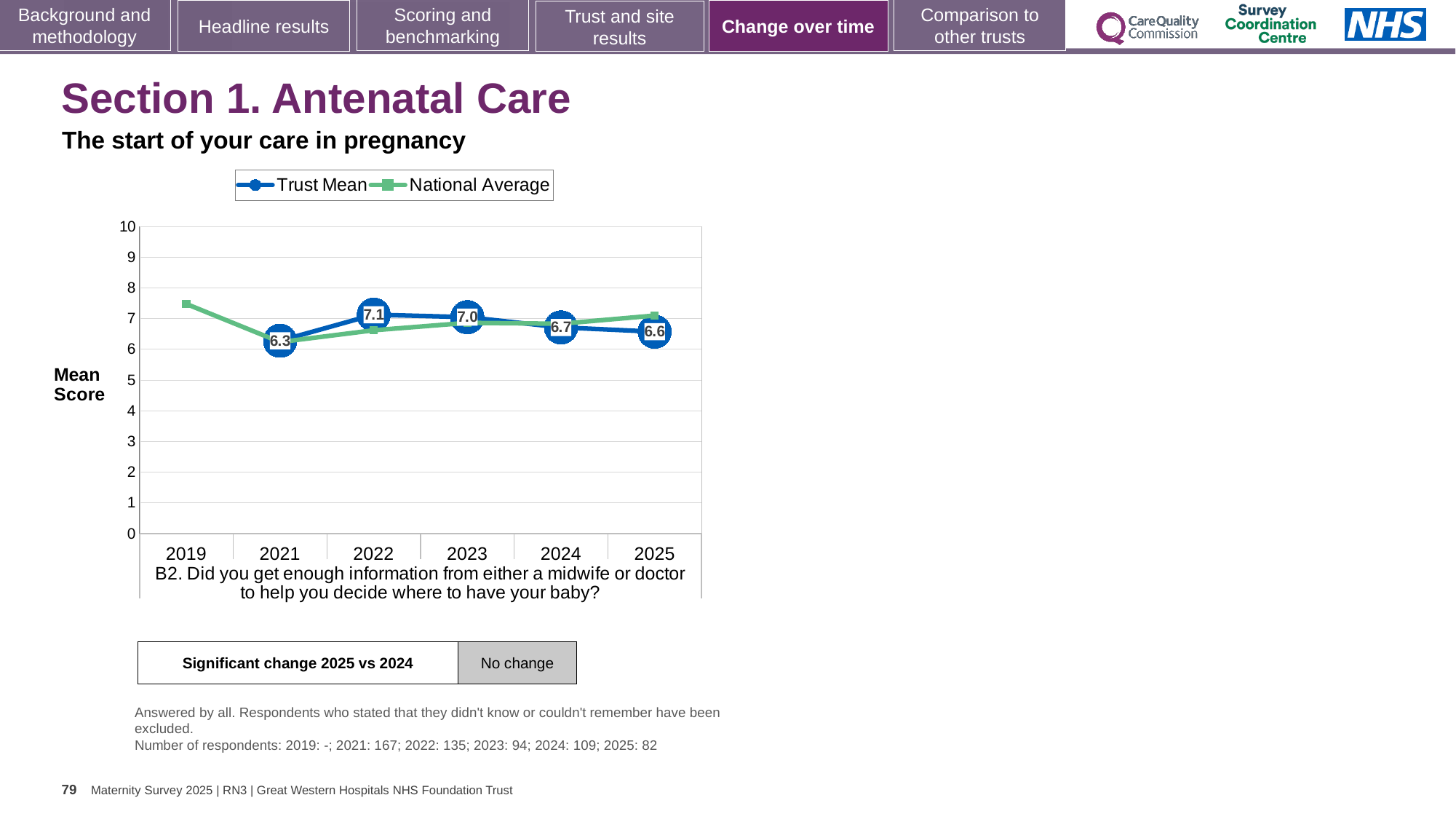
What is the Trust Mean score for 2022? 7.1 In which year is the Trust Mean score lowest? 2021 What is the difference between the Trust Mean scores for 2022 and 2021? 0.8 What is the Trust Mean score for 2025? 6.6 Does the Trust Mean score rise or fall from 2022 to 2025? fall By how much did the Trust Mean score fall from 2024 to 2025? 0.1 In which year is the Trust Mean score highest? 2022 Which year has the larger Trust Mean score, 2023 or 2024? 2023 Is the National Average value for 2019 greater or less than 7? greater What kind of chart is shown on the slide? line chart How many series does the legend list? 2 How many years are shown on the x axis of the chart? 6